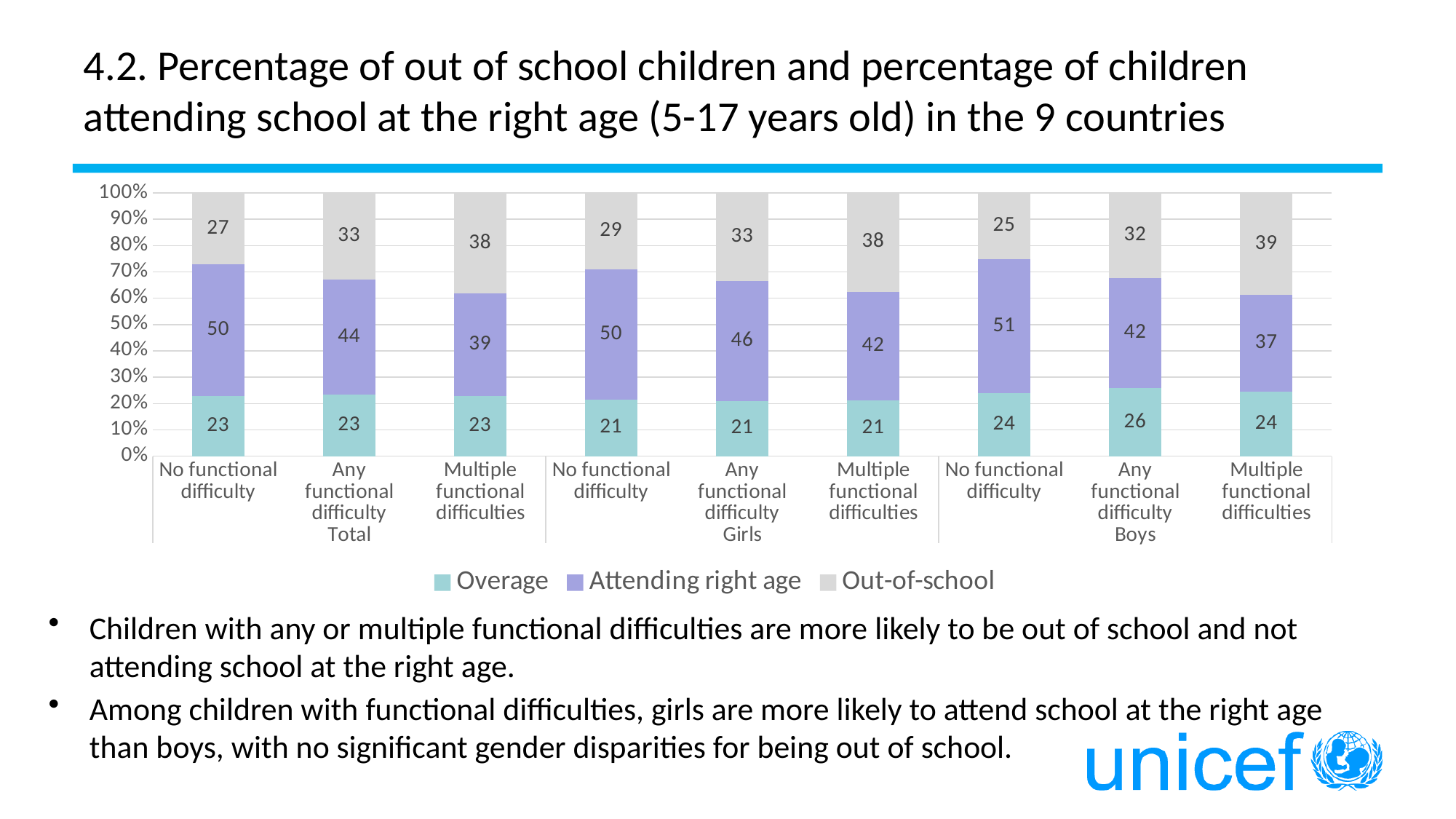
What is the Attending right age value for No functional difficulty in the Total group? 50 How many series does the legend list? 3 Which bar has the lowest Attending right age value? Multiple functional difficulties (Boys) In the Total group, what is the difference between the Out-of-school values for Multiple functional difficulties and No functional difficulty? 11 What is the Out-of-school value for Multiple functional difficulties among Boys? 39 What is the total of the stacked bar for No functional difficulty in the Total group? 100 What kind of chart is shown on the slide? Stacked bar chart What is the Attending right age value for Any functional difficulty among Girls? 46 How many bars are plotted in the chart? 9 What is the Overage value for Any functional difficulty among Boys? 26 For Any functional difficulty, is the Attending right age value larger for Girls or for Boys? Girls Which bar has the highest Out-of-school value? Multiple functional difficulties (Boys)